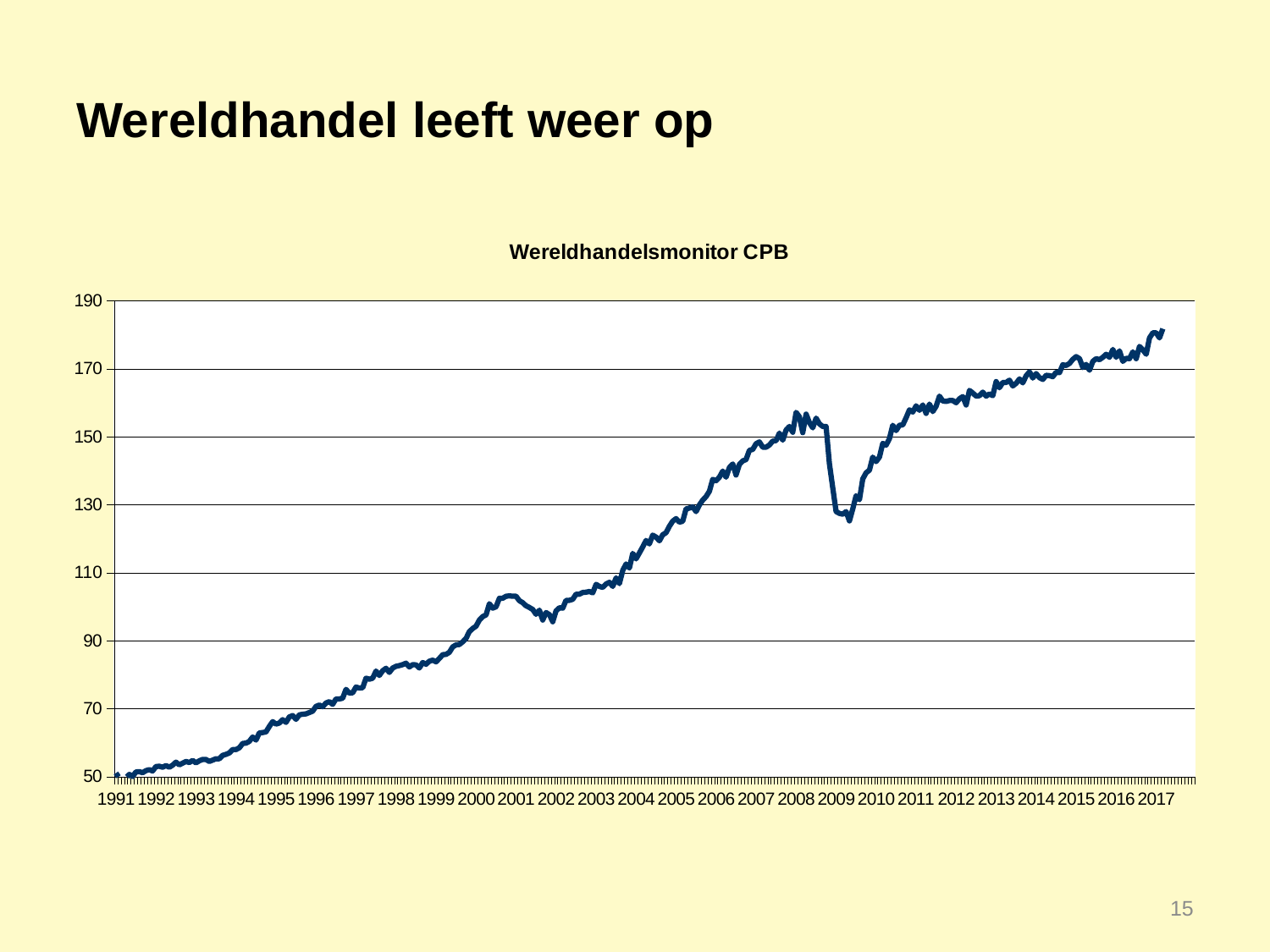
Is the lowest value during 2009 greater or less than 150? less Overall, do the values rise or fall from 1991 to 2017? rise What kind of chart is shown on the slide? line chart In which year does the line have its lowest value? 1991 What is the title of the chart? Wereldhandelsmonitor CPB In which year does the line reach its highest value? 2017 Is the value at the start of 1991 greater or less than 70? less Is the value in 2008 higher or lower than the value in 2009? higher What is the highest value shown on the y axis? 190 Is the value at the end of 2017 greater or less than 170? greater How many year labels are shown on the x axis? 27